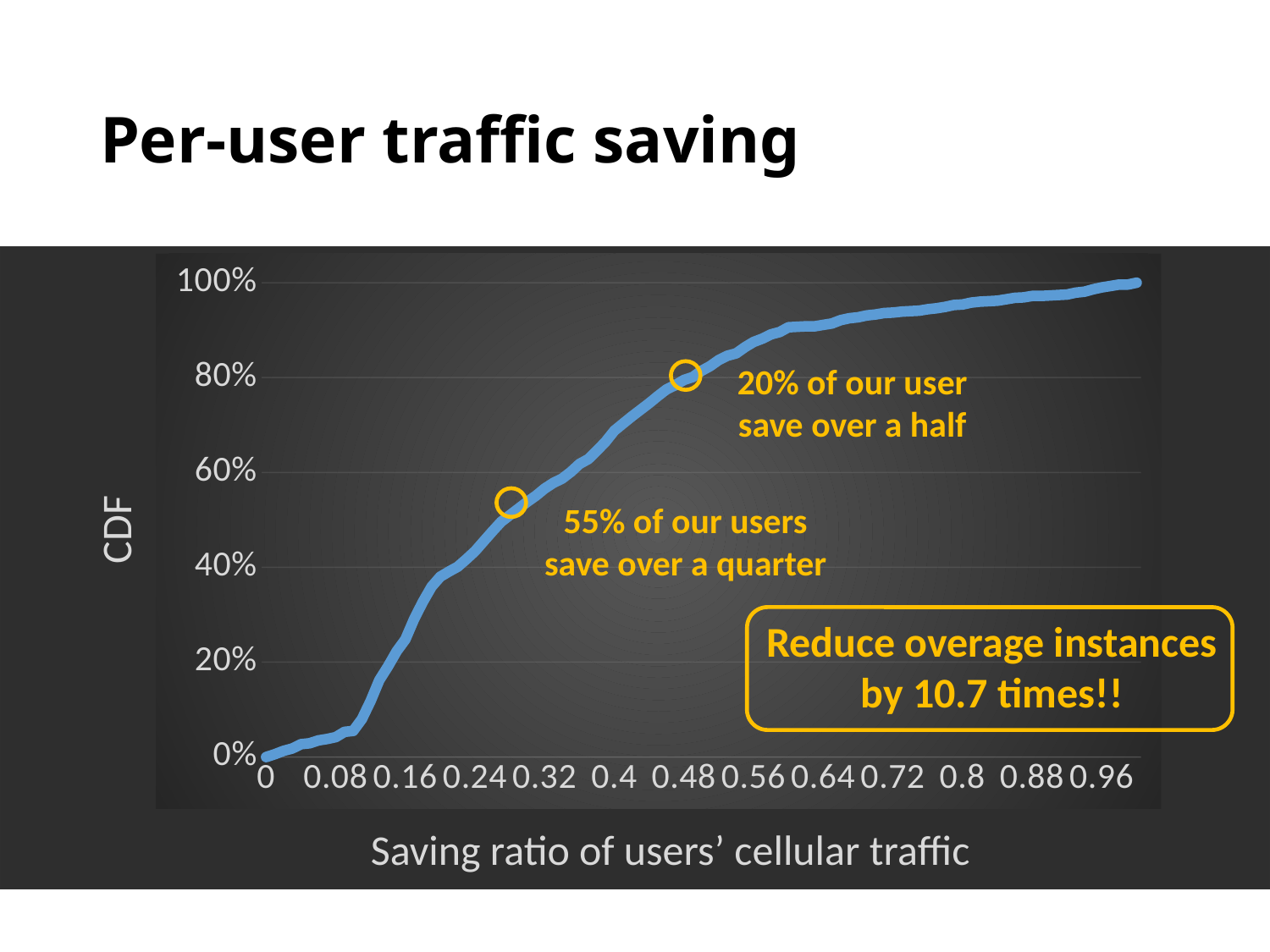
Is the CDF value at a saving ratio of 0.48 greater or less than 60%? greater What is the title of the x axis? Saving ratio of users' cellular traffic How many lines are plotted on the chart? 1 How many tick labels are shown on the x axis? 13 According to the annotation on the chart, what percentage of users save over a quarter of their cellular traffic? 55% What kind of chart is shown on the slide? line chart Is the CDF value at a saving ratio of 0.24 greater or less than 60%? less According to the annotation on the chart, what percentage of users save over a half of their cellular traffic? 20% Is the CDF value at a saving ratio of 0.08 greater or less than 20%? less Does the CDF curve rise or fall as the saving ratio increases along the x axis? rise Which saving ratio has the higher CDF value, 0.16 or 0.56? 0.56